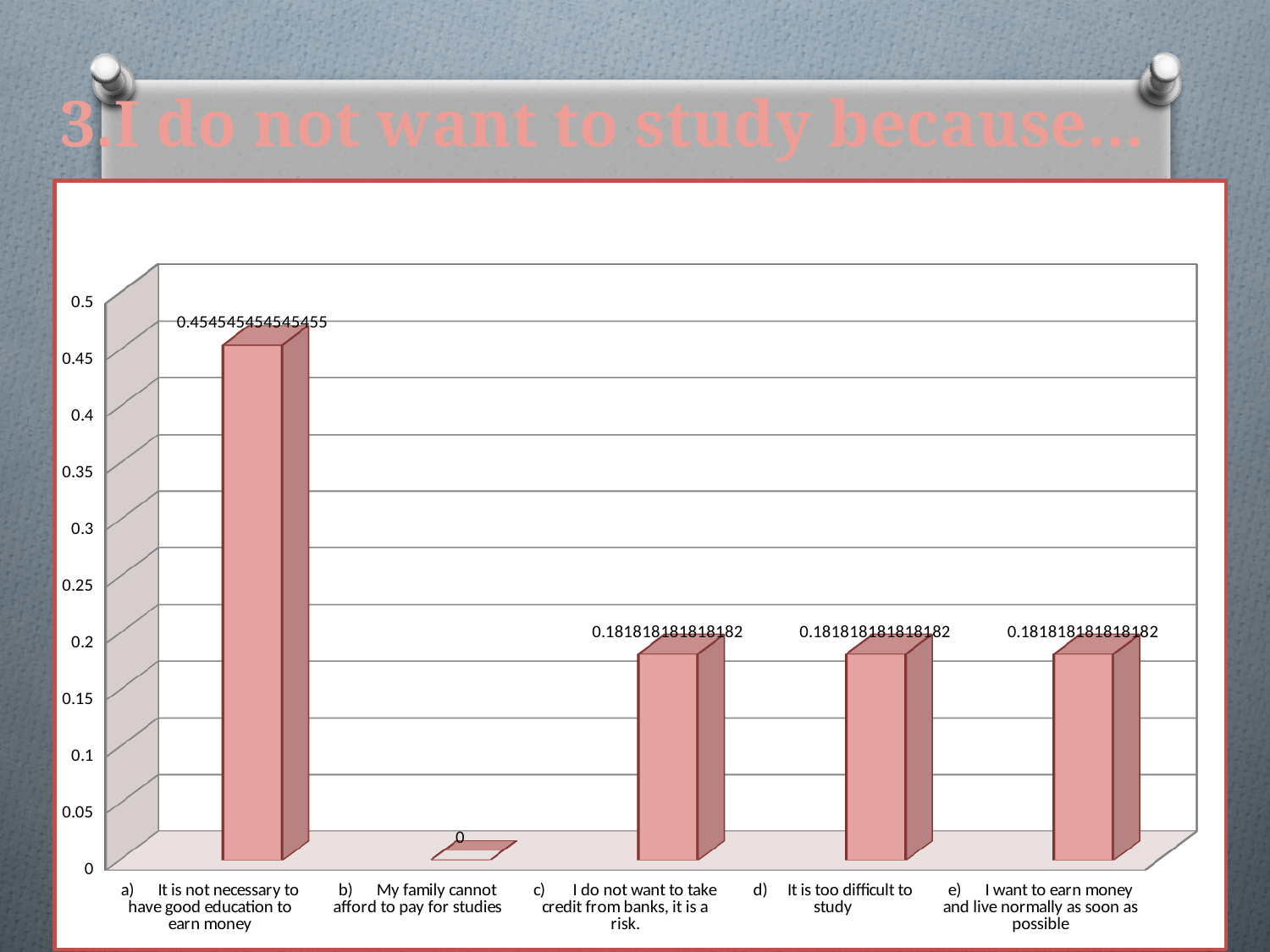
What is the title of the slide? 3.I do not want to study because... Which category has the lowest value? b) My family cannot afford to pay for studies What is the difference between the value for category a) and the value for category c)? 0.272727272727273 What is the value for "b) My family cannot afford to pay for studies"? 0 Is the value for "c) I do not want to take credit from banks, it is a risk." greater or less than 0.2? less What is the value for "d) It is too difficult to study"? 0.181818181818182 Which category has the highest value? a) It is not necessary to have good education to earn money Which is larger: the value for "a) It is not necessary to have good education to earn money" or the value for "e) I want to earn money and live normally as soon as possible"? a) It is not necessary to have good education to earn money What is the value for "a) It is not necessary to have good education to earn money"? 0.454545454545455 How many categories are shown on the x axis? 5 What kind of chart is shown on the slide? bar chart Is the value for category a) greater or less than 0.4? greater